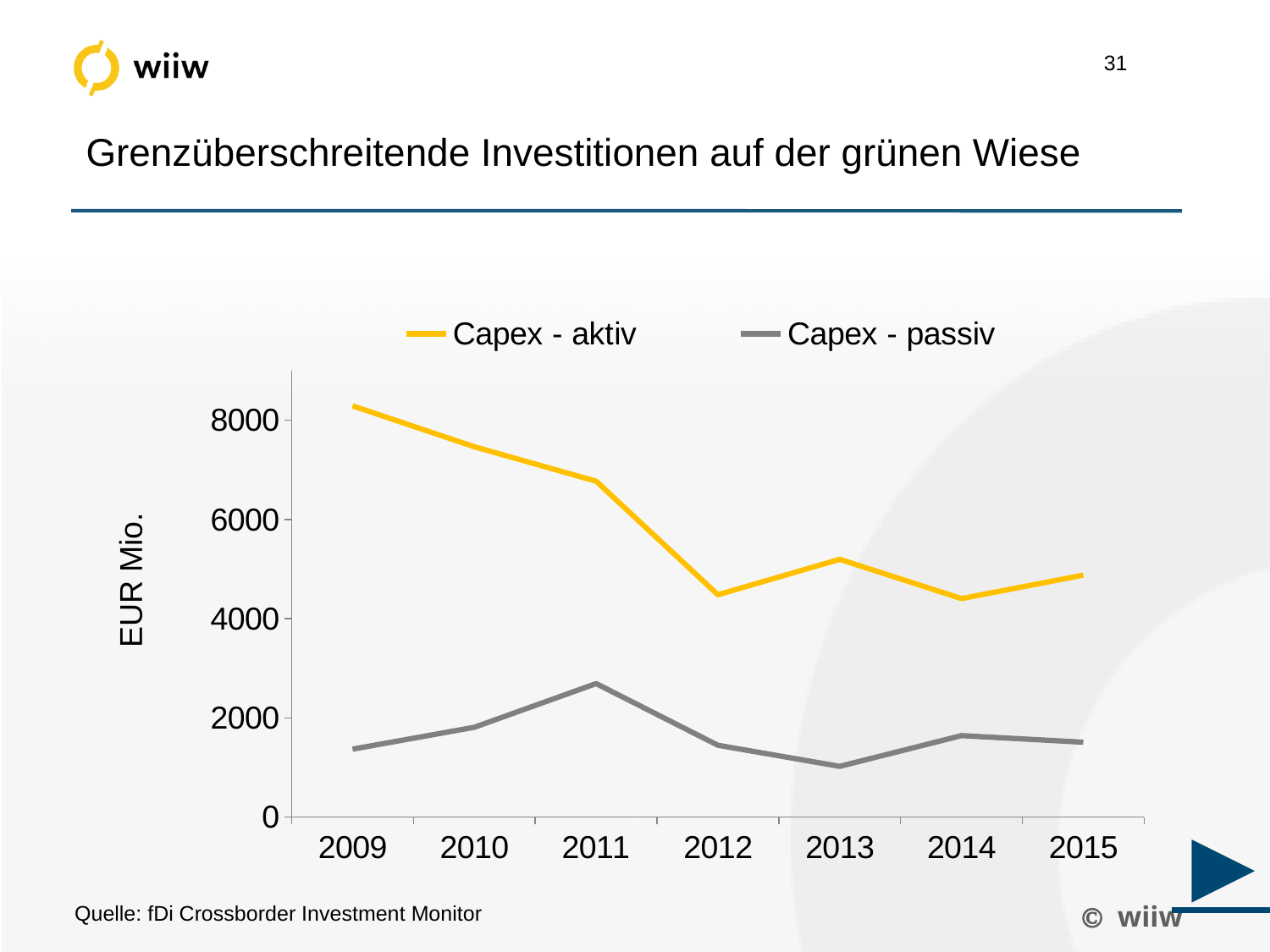
How many years are shown on the x axis? 7 In which year is Capex - passiv lowest? 2013 Which is larger in 2011, Capex - aktiv or Capex - passiv? Capex - aktiv In which year is Capex - passiv highest? 2011 Is the value for Capex - aktiv in 2009 greater or less than 8000? greater In which year is Capex - aktiv highest? 2009 What kind of chart is shown on the slide? line chart How many series does the legend list? 2 Is the value for Capex - aktiv in 2012 greater or less than 4000? greater What is the label on the y axis? EUR Mio. Is the value for Capex - passiv in 2011 greater or less than 2000? greater Does Capex - aktiv rise or fall from 2009 to 2012? fall